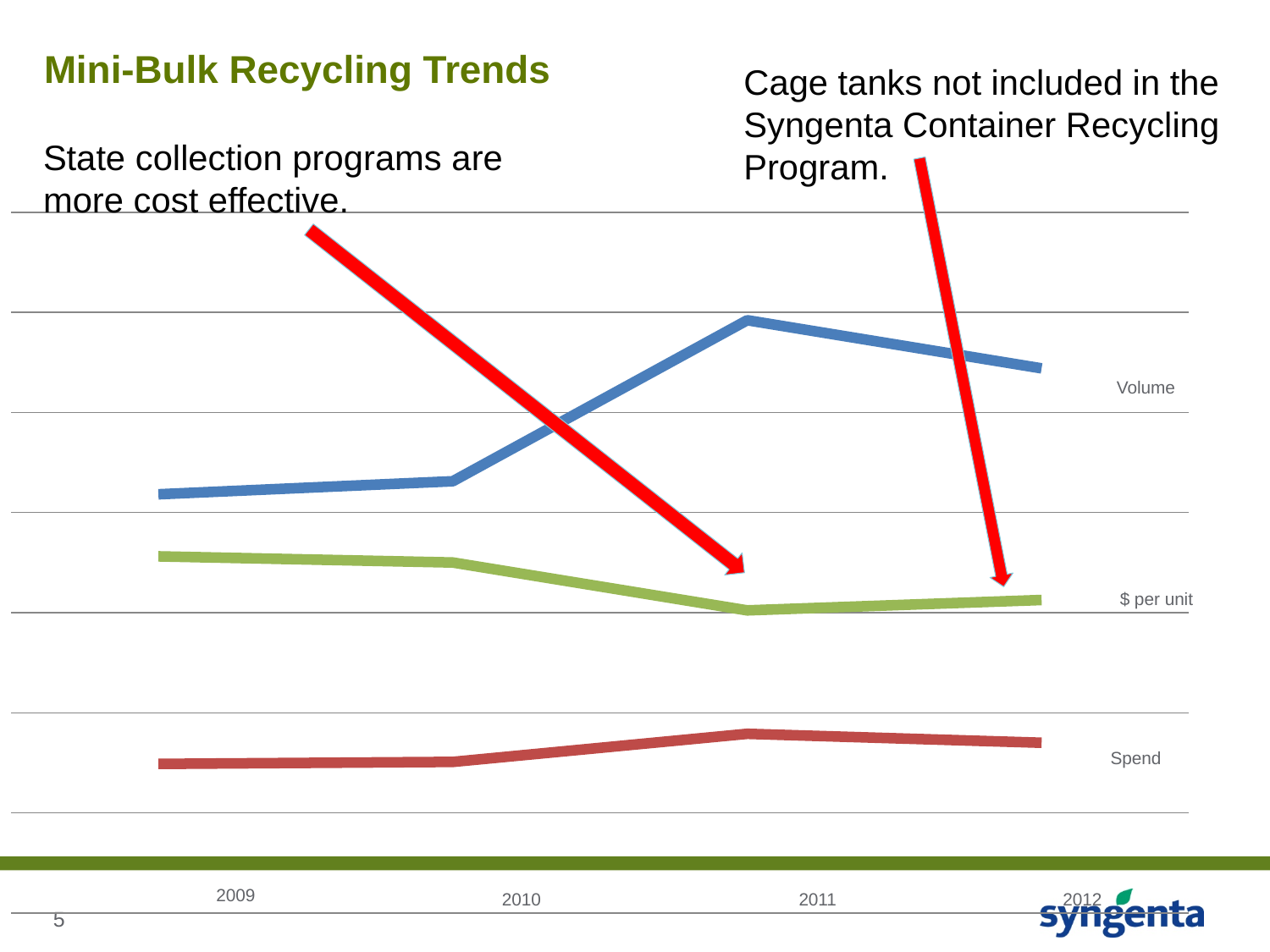
How many years are shown on the x axis of the chart? 4 In which year is Volume highest? 2011 Which year has the larger $ per unit, 2009 or 2011? 2009 Does Volume rise or fall from 2009 to 2011? rise How many series are plotted on the chart? 3 In which year is Spend highest? 2011 Does $ per unit rise or fall from 2009 to 2011? fall In which year is Volume lowest? 2009 What kind of chart is shown on the slide? line chart In which year is $ per unit lowest? 2011 What is the title of the chart on the slide? Mini-Bulk Recycling Trends Which year has the larger Volume, 2011 or 2012? 2011